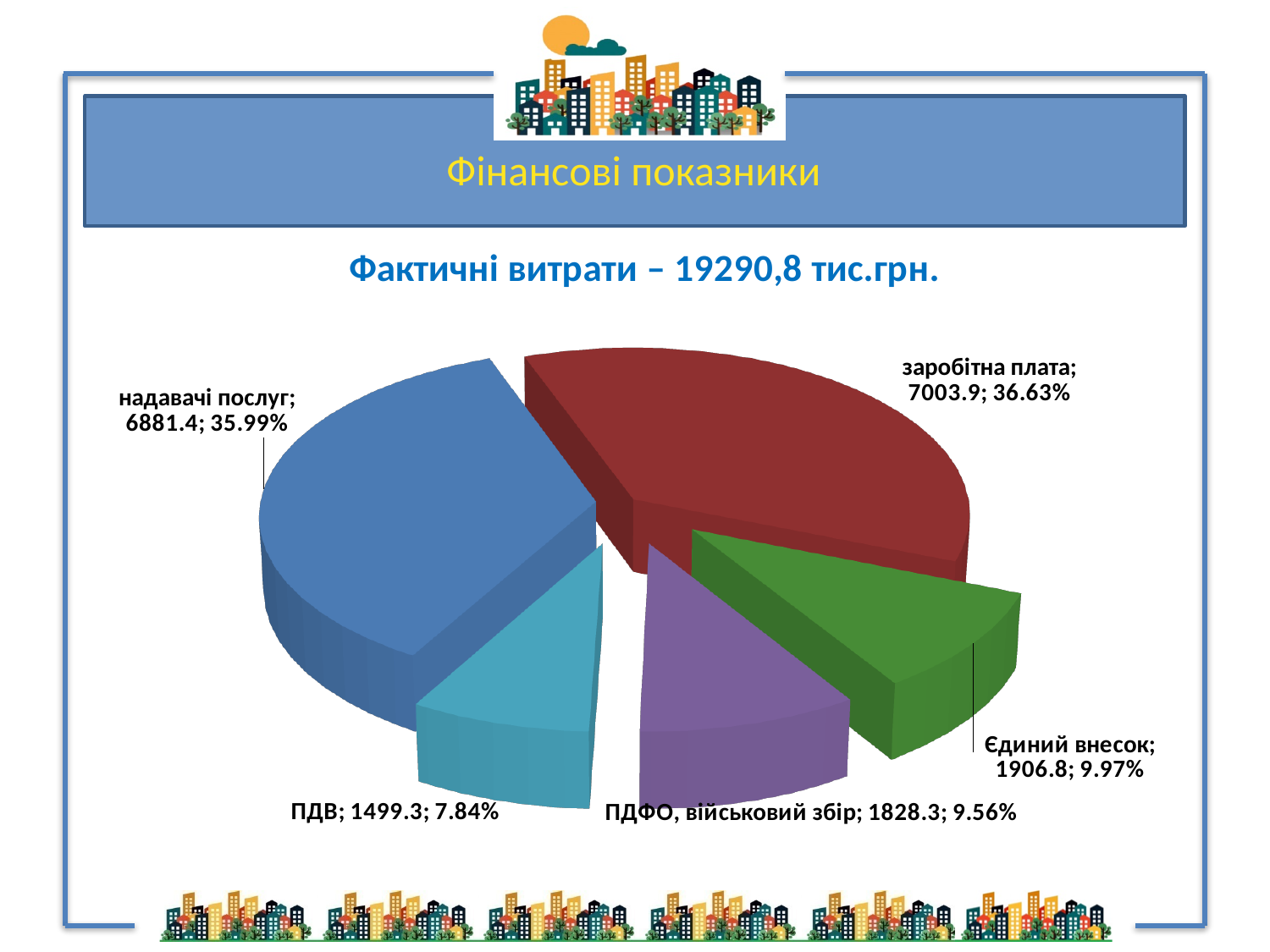
What share of the pie does ПДФО, військовий збір represent? 9.56% What share of the pie does Єдиний внесок represent? 9.97% How many slices does the pie chart have? 5 What total amount of actual expenses is stated in the chart heading? 19290,8 тис.грн. What is the difference between the values for заробітна плата and надавачі послуг? 122.5 What kind of chart is shown on the slide? pie chart What is the value for заробітна плата? 7003.9 Which category has the largest slice? заробітна плата What is the value for ПДВ? 1499.3 Which category has the smallest slice? ПДВ Which is larger, the value for Єдиний внесок or the value for ПДФО, військовий збір? Єдиний внесок What is the value for надавачі послуг? 6881.4